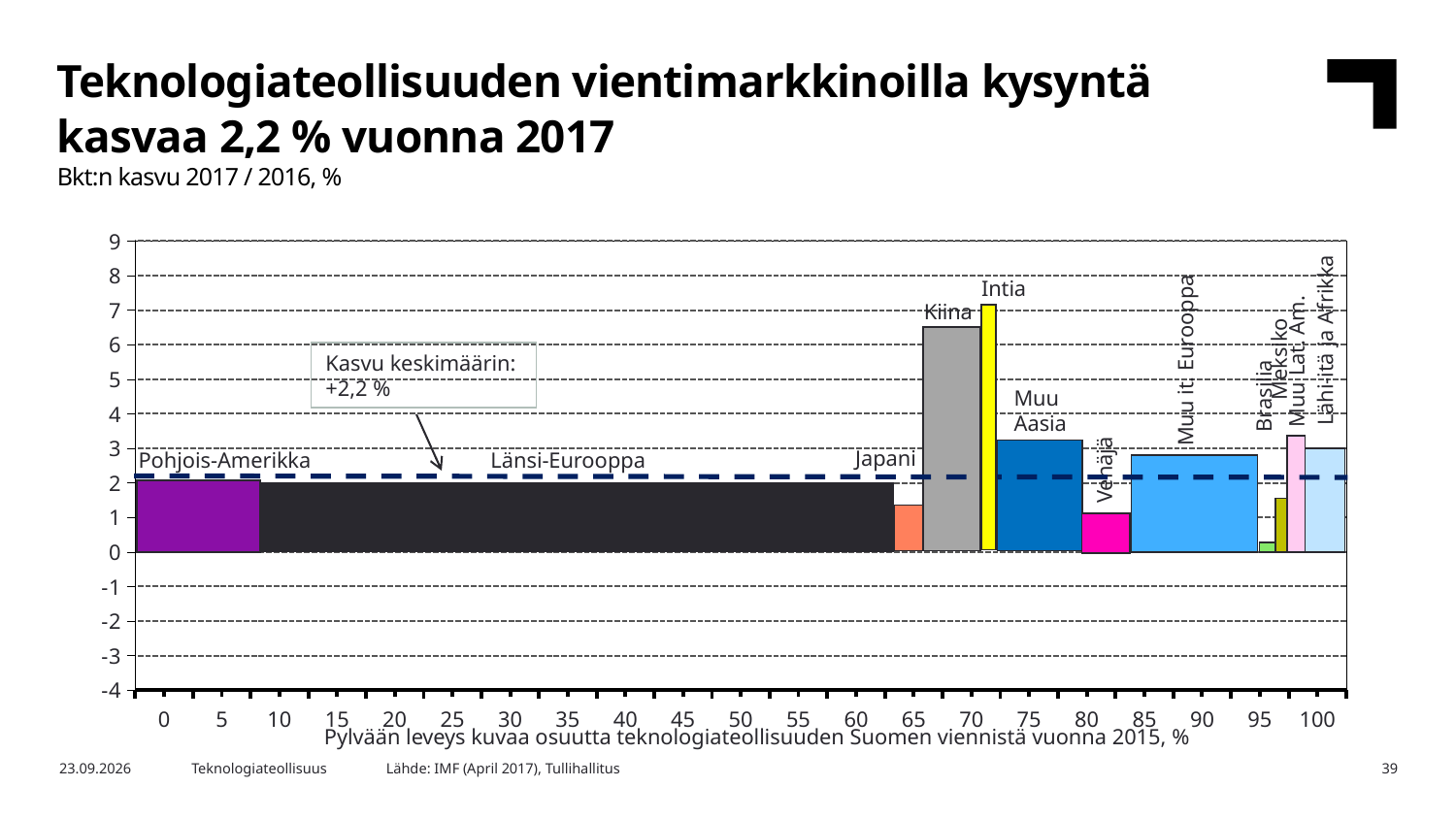
Which region has the highest GDP growth in the chart? Intia Is the value for Venäjä greater or less than 2? less Which has higher GDP growth, Kiina or Japani? Kiina Which region has the lowest GDP growth in the chart? Brasilia Is the value for Kiina greater or less than 6? greater According to the note under the x axis, what does the width of each bar represent? Share of Finland's technology industry exports in 2015, % What average growth (Kasvu keskimäärin) is marked by the dashed line in the chart? +2,2 % What kind of chart is shown on the slide? bar chart How many regions are shown as bars in the chart? 12 Which has higher GDP growth, Intia or Kiina? Intia Is the value for Brasilia greater or less than 1? less Which has higher GDP growth, Muu Aasia or Venäjä? Muu Aasia